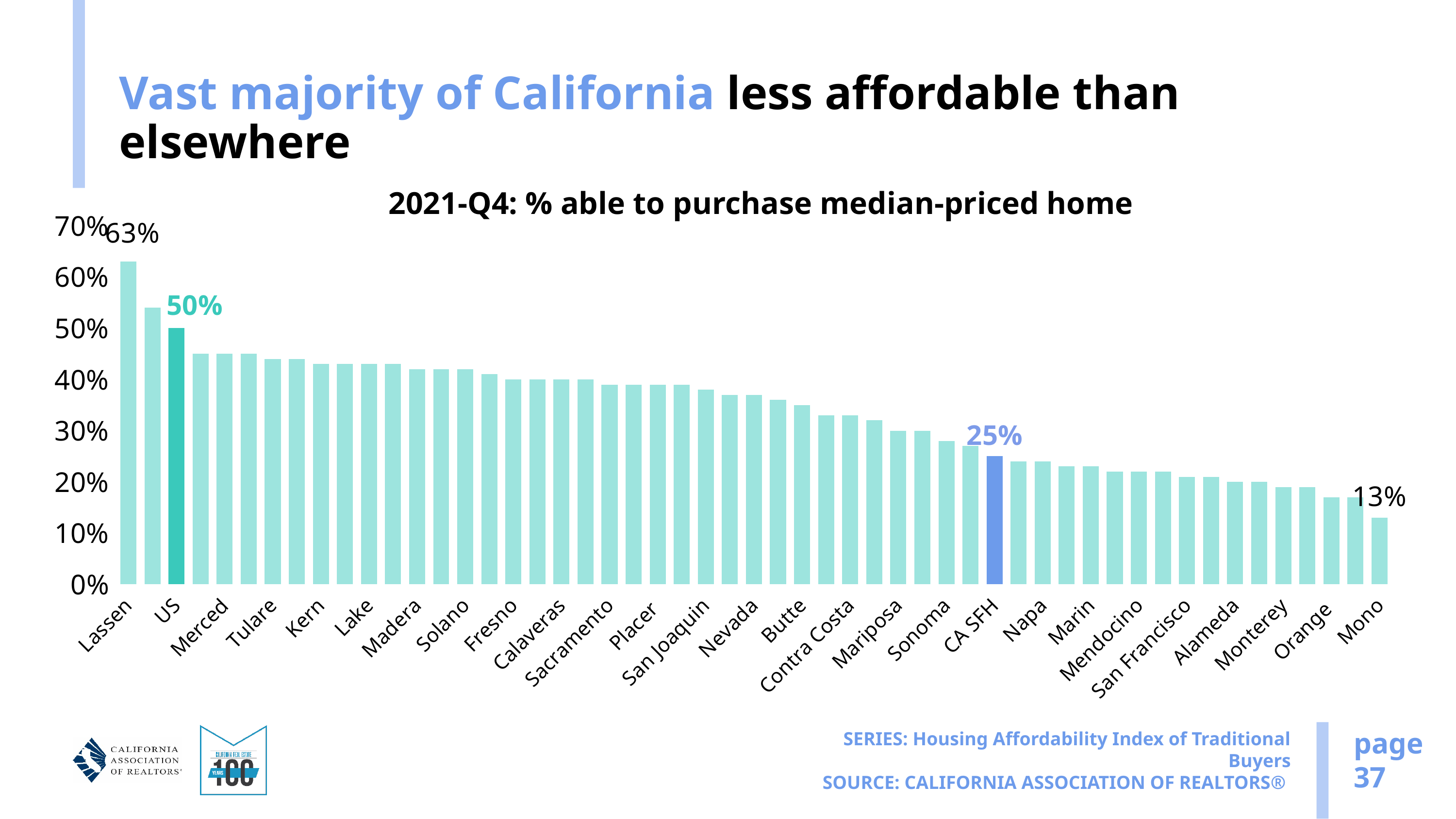
What is the value for CA SFH? 25% What is the difference between the values for US and CA SFH? 25 percentage points What is the value for Mono? 13% Which category has the lowest value? Mono Is the value for Merced greater or less than 40%? greater Is the value for San Francisco greater or less than 30%? less What is the value for US? 50% What is the value for Lassen? 63% Do the values rise or fall from left to right along the x axis? fall Which is larger, the value for US or the value for CA SFH? US What kind of chart is shown on the slide? bar chart Which category has the highest value? Lassen